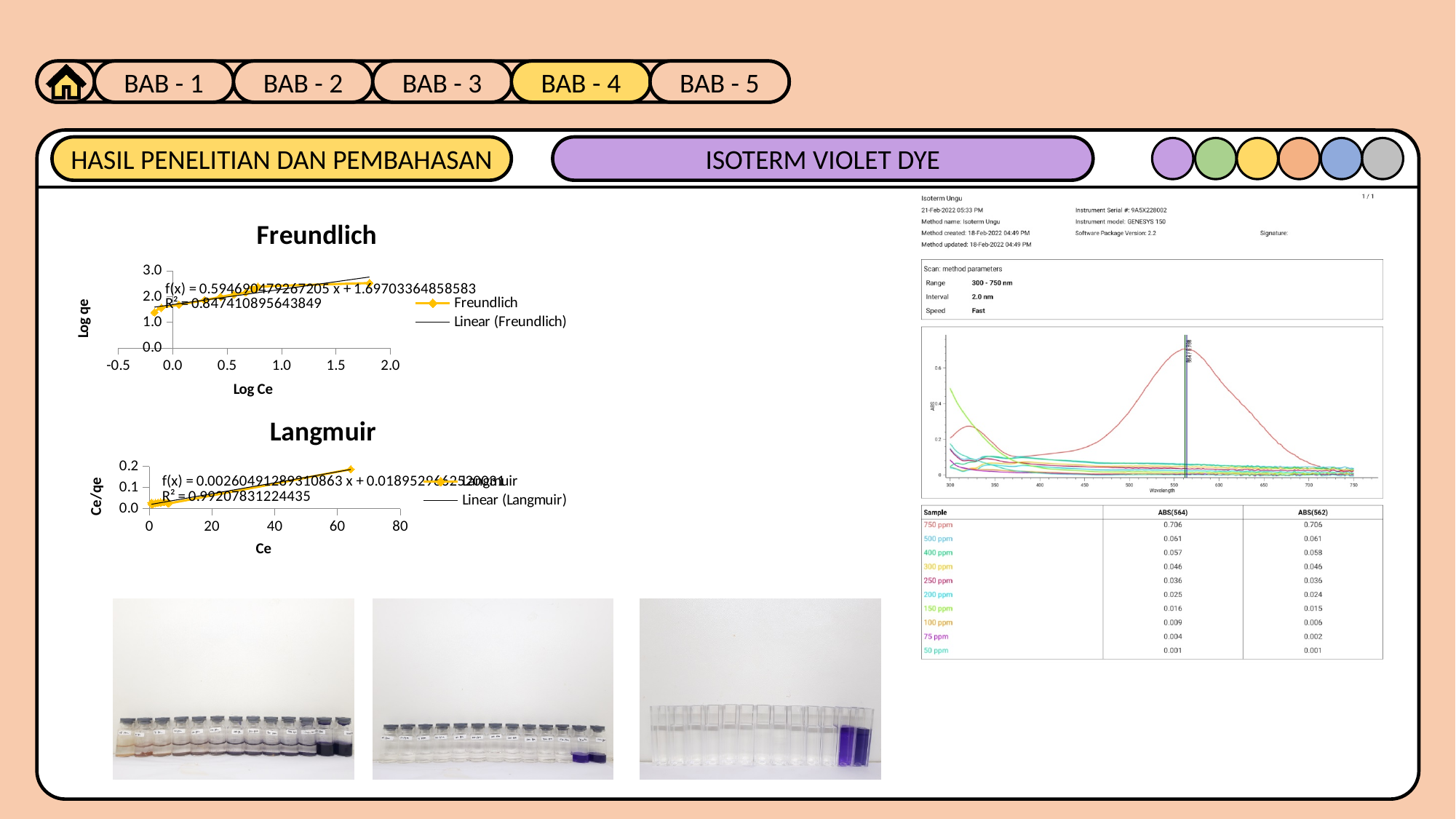
In the Freundlich chart, do the Log qe values rise or fall as Log Ce increases? rise What is the x-axis label of the Langmuir chart? Ce What is the R² value shown on the Freundlich chart? 0.847410895643849 What type of chart is the Langmuir chart? scatter chart with a linear trendline How many entries does the legend of the Freundlich chart list? 2 How many entries does the legend of the Langmuir chart list? 2 Which chart has the higher R² value, Freundlich or Langmuir? Langmuir In the Freundlich chart, is the Log qe value of the rightmost data point greater or less than 2.0? greater In the Langmuir chart, is the Ce/qe value of the rightmost data point greater or less than 0.1? greater In the Langmuir chart, do the Ce/qe values rise or fall as Ce increases? rise What is the R² value shown on the Langmuir chart? 0.99207831224435 What type of chart is the Freundlich chart? scatter chart with a linear trendline